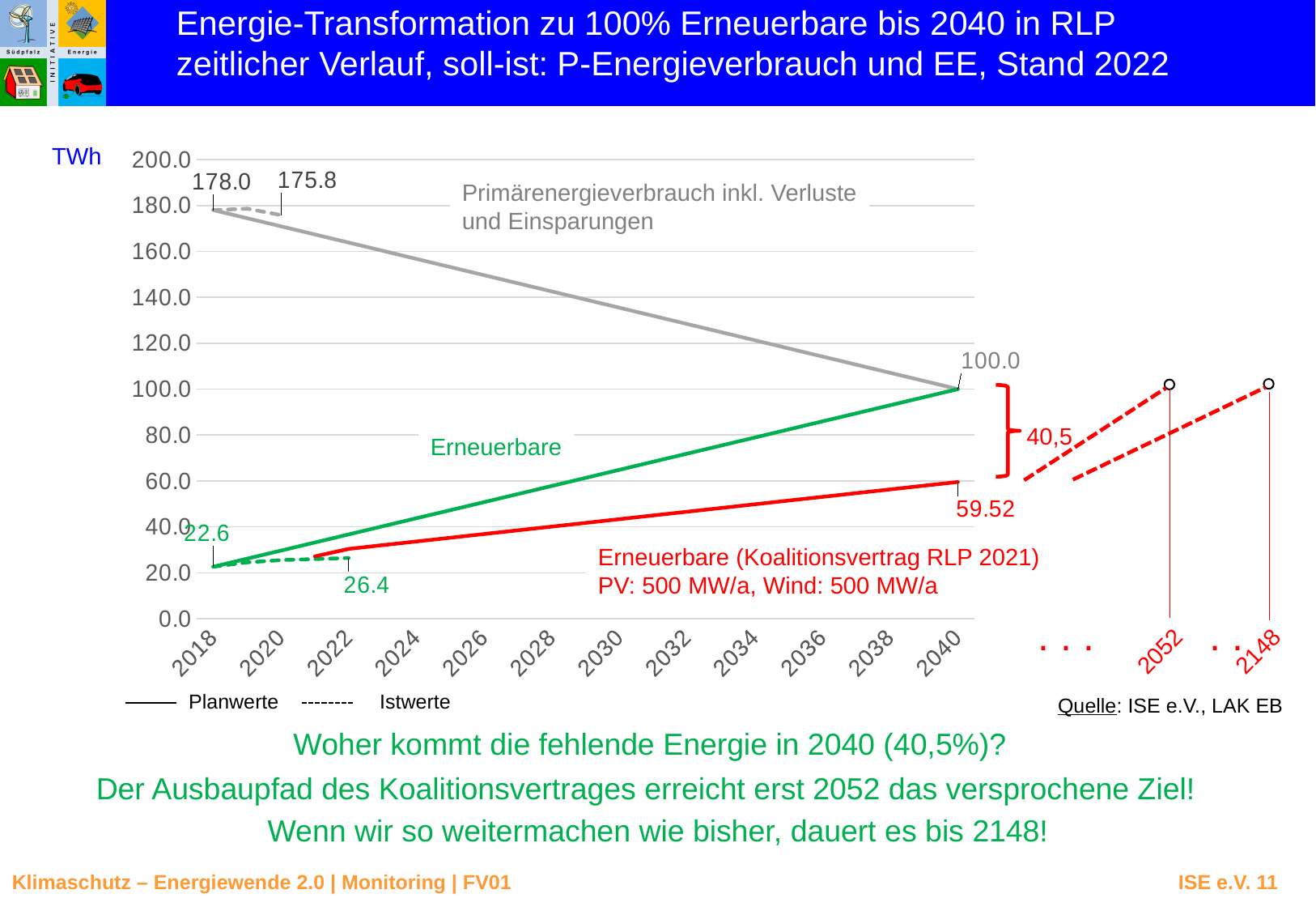
What is the value of Erneuerbare in 2018? 22.6 What is the value of Primärenergieverbrauch in 2018? 178.0 By how much does the Primärenergieverbrauch plan value fall from 2018 to 2040? 78.0 What value does the Erneuerbare (Koalitionsvertrag RLP 2021) line reach in 2040? 59.52 Does the Primärenergieverbrauch line rise or fall from 2018 to 2040? fall What is the planned value of Primärenergieverbrauch in 2040? 100.0 What type of chart is shown on the slide? line chart What is the difference between the Erneuerbare plan value in 2040 (100.0) and the Koalitionsvertrag value in 2040 (59.52)? 40.48 What unit is shown on the y axis of the chart? TWh Is the Erneuerbare plan value in 2030 greater or less than 40? greater What is the Istwert for Erneuerbare in 2022? 26.4